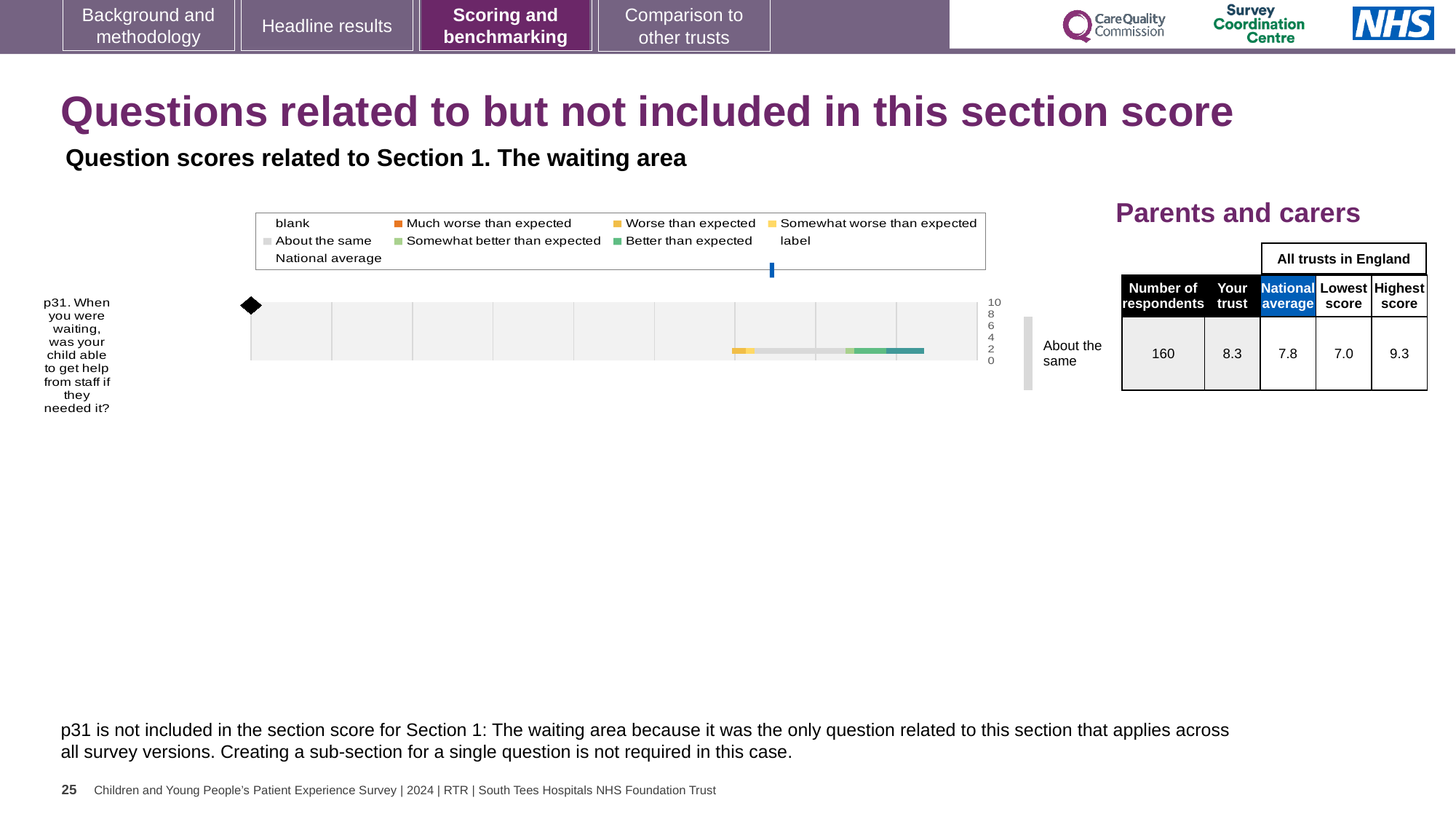
What benchmark category label is shown to the right of the p31 bar? About the same What is the highest value shown on the chart's axis? 10 Which question is plotted in the chart? p31. When you were waiting, was your child able to get help from staff if they needed it? What kind of chart is used to show the p31 question score? bar chart How many entries does the chart legend list? 9 Is the 'Your trust' score for p31 higher or lower than the national average? higher In the table next to the chart, what is the national average score for p31? 7.8 In the table next to the chart, what is the highest score among all trusts in England for p31? 9.3 How many questions (categories) are plotted in the chart? 1 In the table next to the chart, what is the lowest score among all trusts in England for p31? 7.0 In the table next to the chart, how many respondents answered p31? 160 In the table next to the chart, what is the 'Your trust' score for p31? 8.3